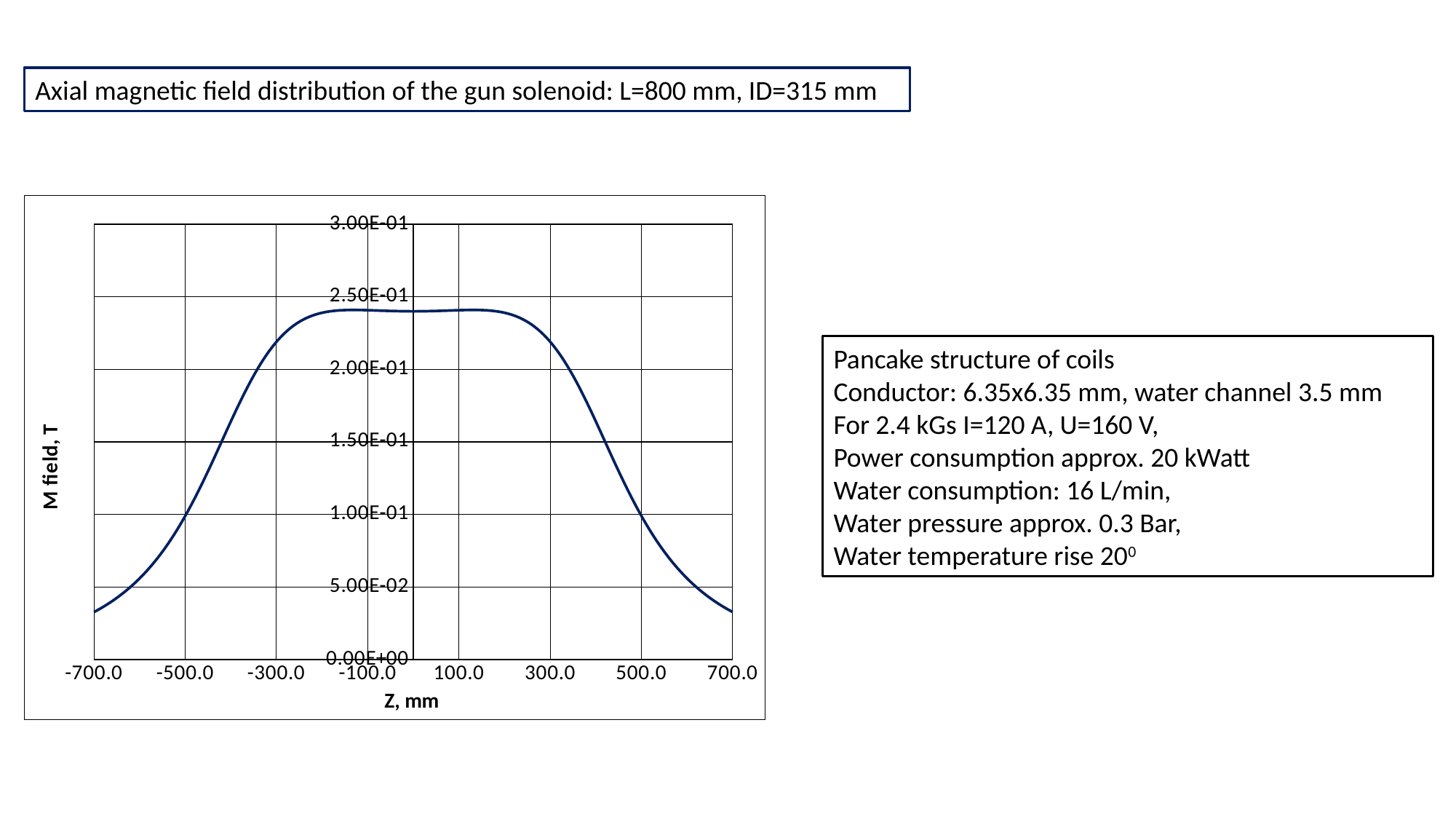
Is the value of the M field at Z = -700.0 mm greater or less than 5.00E-02? less Does the M field rise or fall as Z increases from -700.0 mm to 0 mm? rise Is the value of the M field at Z = -300.0 mm greater or less than 2.00E-01? greater Is the value of the M field at Z = 0 mm greater or less than 2.00E-01? greater Does the M field rise or fall as Z increases from 100.0 mm to 700.0 mm? fall What is the label of the x axis of the chart? Z, mm What is the label of the y axis of the chart? M field, T Which has the larger M field value: Z = 0 mm or Z = 500.0 mm? Z = 0 mm What kind of chart is shown on the slide? line chart